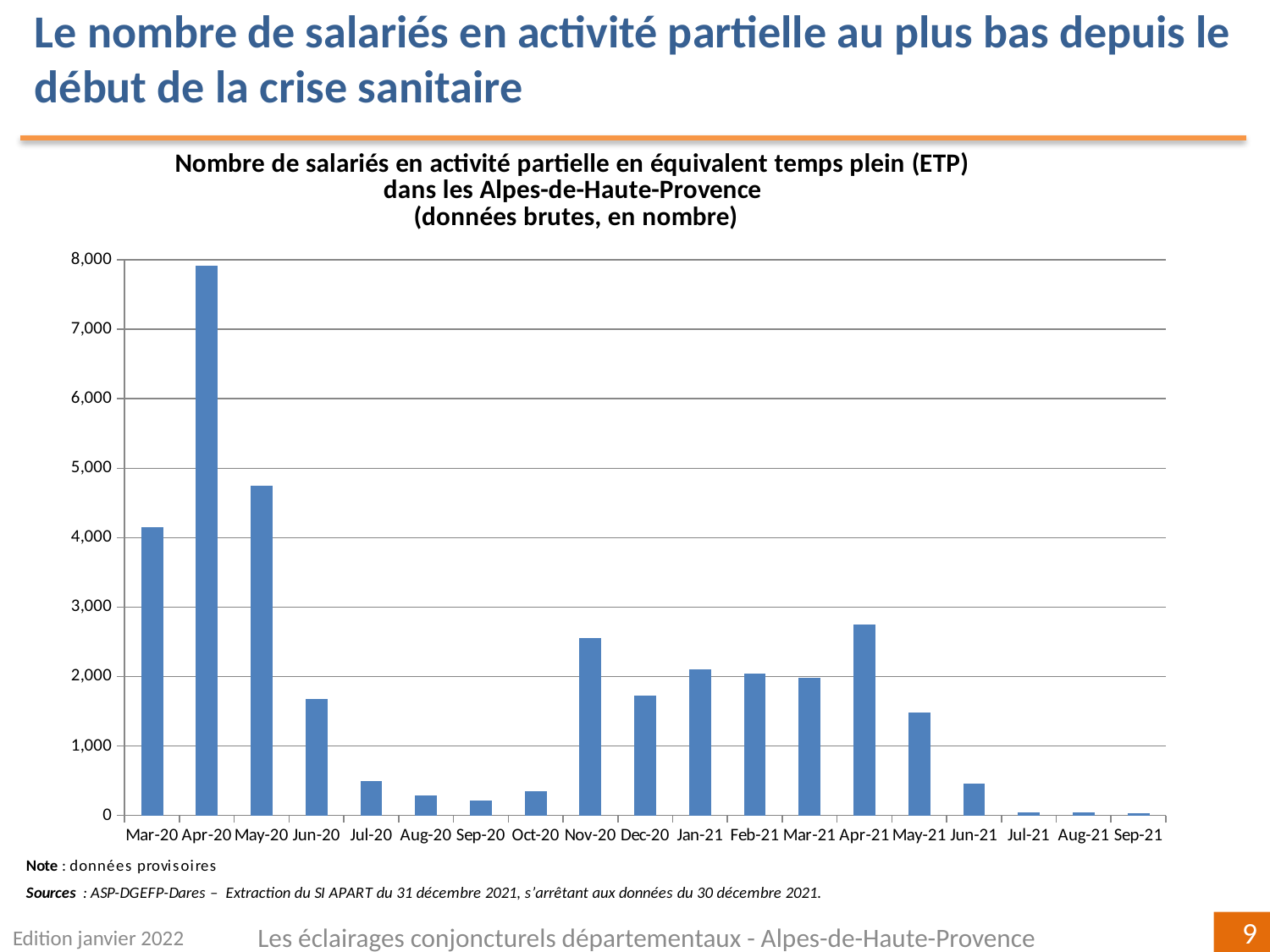
Is the value for Nov-20 greater or less than 2,000? greater Which département does the chart title say the data is for? Alpes-de-Haute-Provence Which is larger, the value for Mar-20 or the value for May-20? May-20 How many months are plotted on the x axis of the chart? 19 Is the value for May-20 greater or less than 5,000? less Is the value for Apr-21 greater or less than 3,000? less What kind of chart is shown on the slide? bar chart Which month has the highest number of salariés en activité partielle? Apr-20 Do the values rise or fall from Apr-21 to Sep-21? fall